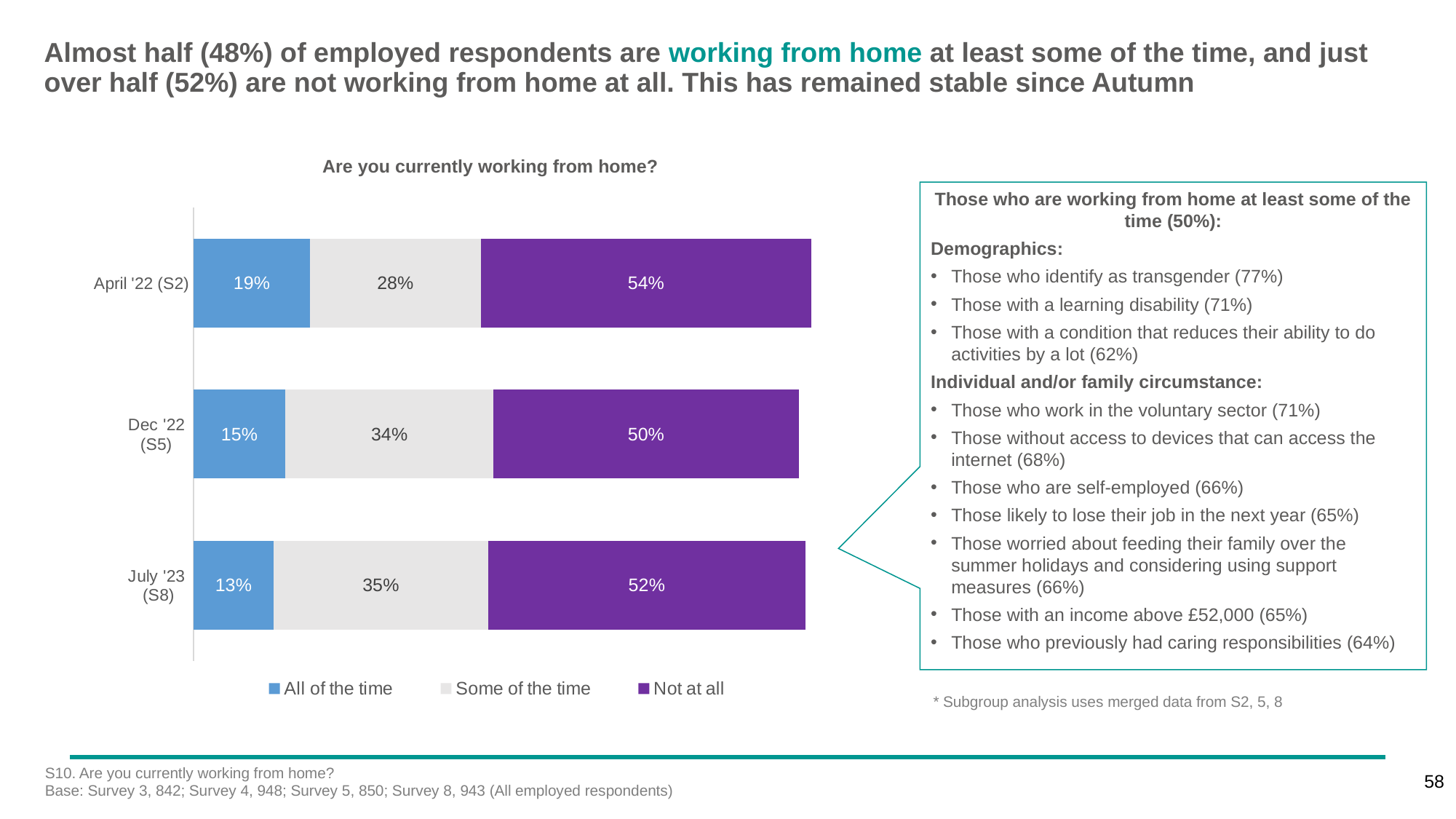
Does the 'All of the time' share rise or fall from April '22 to July '23? Fall Which is larger: the 'Some of the time' share in Dec '22 (S5) or in April '22 (S2)? Dec '22 (S5) What percentage of respondents in April '22 (S2) were working from home all of the time? 19% In which survey wave was the 'Some of the time' share lowest? April '22 (S2) What is the title of the chart? Are you currently working from home? What share of respondents in July '23 (S8) were working from home some of the time? 35% How many series does the chart legend list? 3 What is the 'Not at all' value for Dec '22 (S5)? 50% How many survey waves are shown in the chart? 3 What type of chart is used to show the working-from-home responses? Stacked bar chart In which survey wave was the 'All of the time' share highest? April '22 (S2) What is the difference between the 'Not at all' values for April '22 (S2) and Dec '22 (S5)? 4 percentage points